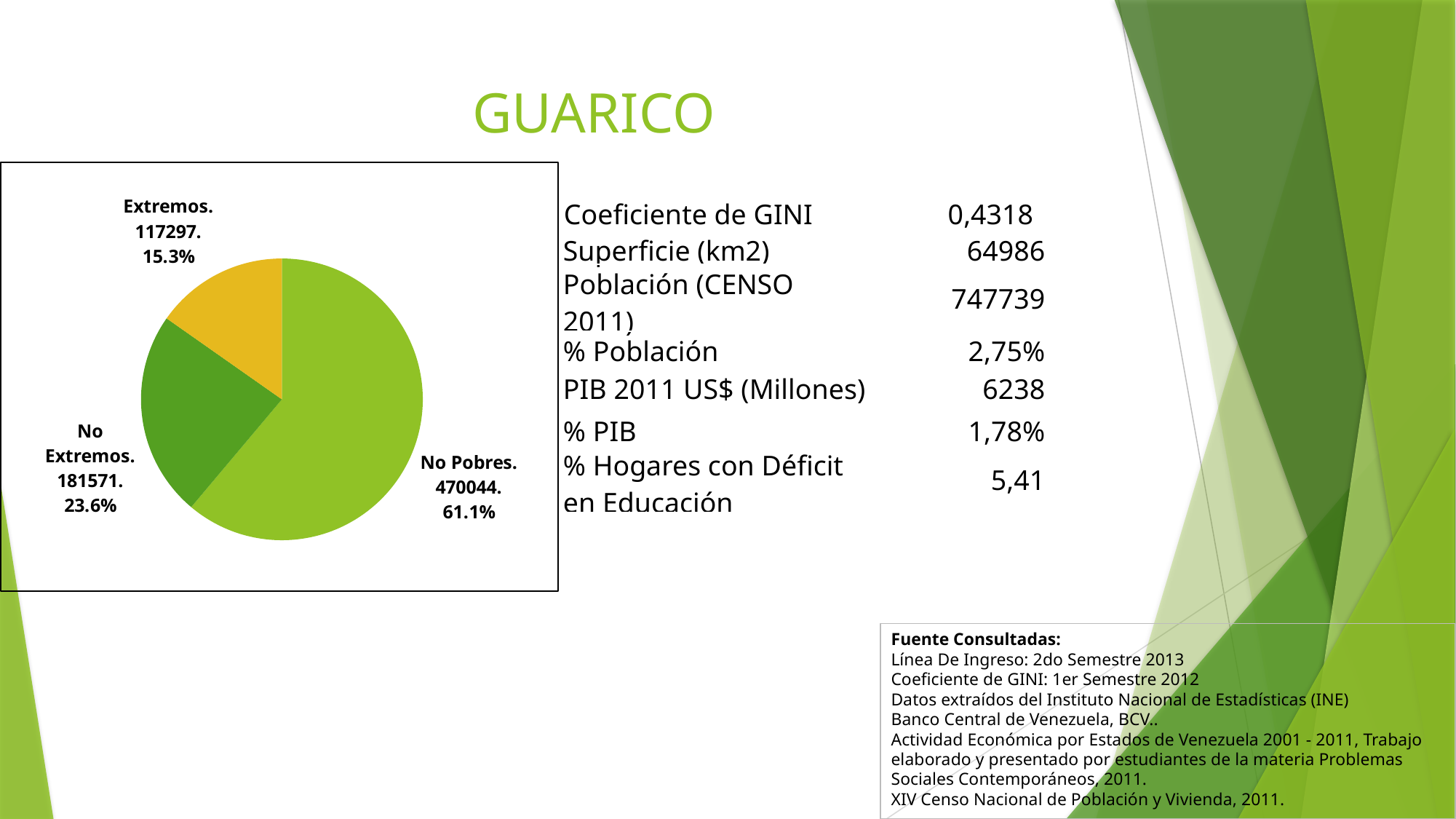
Which slice of the pie chart is the smallest? Extremos Which is larger, the No Extremos slice or the Extremos slice? No Extremos What value is shown for the No Extremos slice? 181571 What percentage share does the No Extremos slice have? 23.6% What value is shown for the No Pobres slice? 470044 What percentage share does the Extremos slice have? 15.3% What percentage share does the No Pobres slice have? 61.1% Which slice of the pie chart is the largest? No Pobres What is the difference between the No Extremos value and the Extremos value? 64274 What colour is the Extremos slice? yellow What kind of chart is shown on the slide? pie chart How many slices does the pie chart have? 3